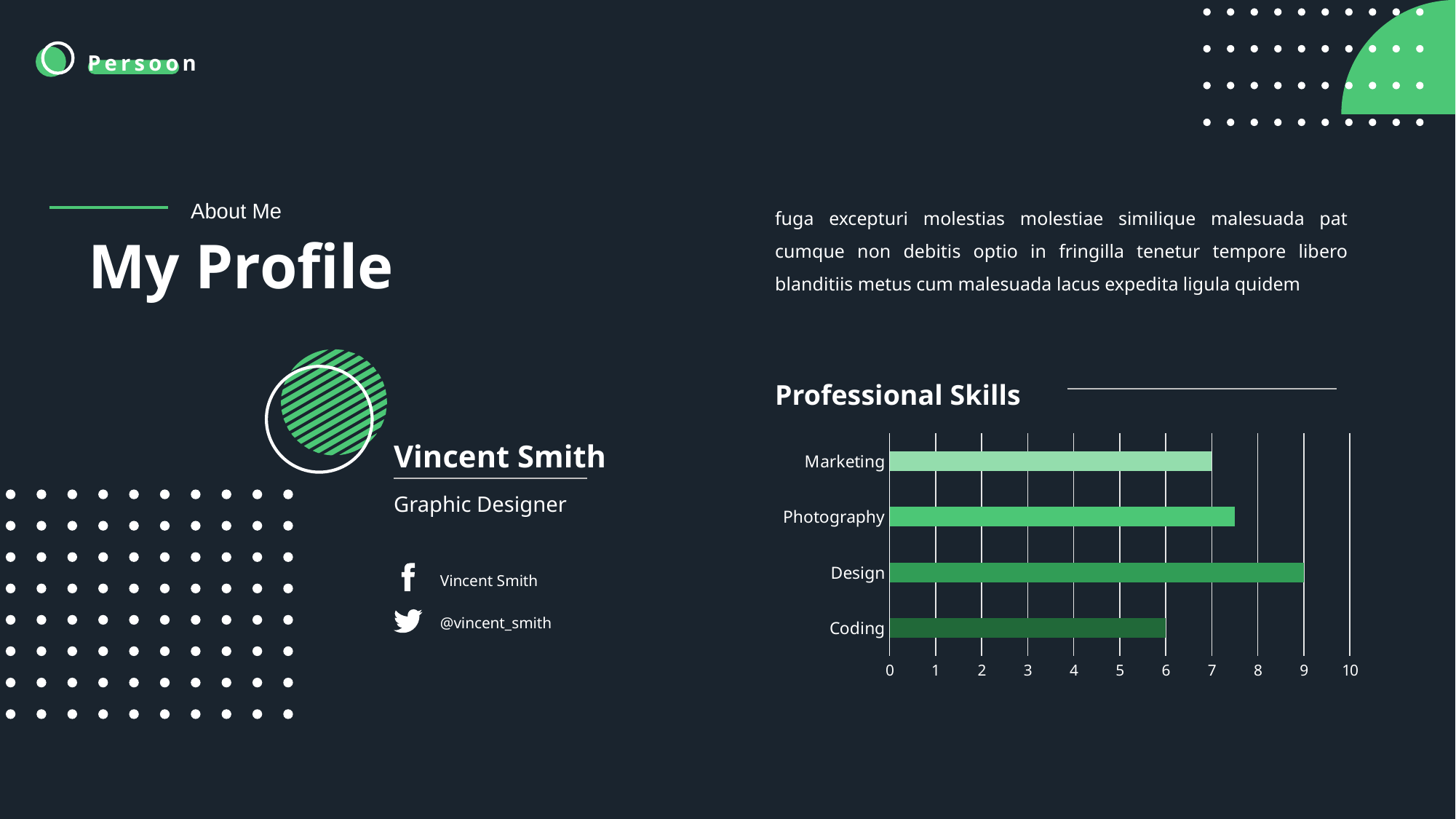
What is the value for Marketing in the Professional Skills chart? 7 Which skill has the highest value in the Professional Skills chart? Design What is the value for Coding in the Professional Skills chart? 6 Is the value for Photography greater or less than 8? less Which is larger in the Professional Skills chart, Design or Coding? Design What is the value for Design in the Professional Skills chart? 9 How many skill categories are plotted in the Professional Skills chart? 4 What kind of chart is shown under Professional Skills? bar chart What is the difference between the values for Design and Coding? 3 What is the title of the chart on the slide? Professional Skills Is the value for Photography greater or less than 7? greater Which skill has the lowest value in the Professional Skills chart? Coding